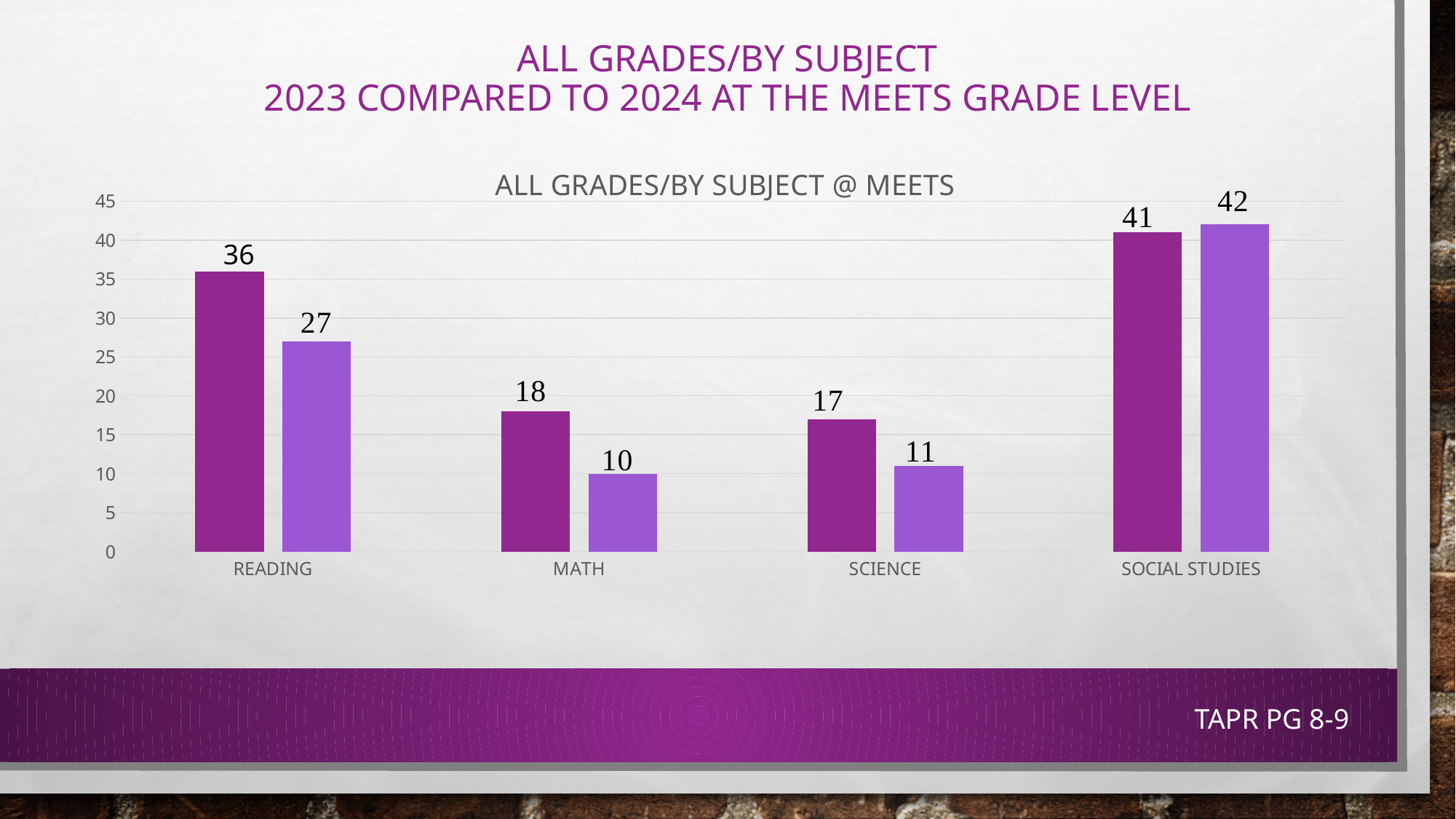
What is the value of the lighter (right) bar for Math? 10 For Math, which is larger: the darker (left) bar or the lighter (right) bar? the darker (left) bar Is the value of the darker (left) bar for Social Studies greater or less than 40? greater Which subject has the lowest value among the darker (left) bars? Science What is the value of the darker (left) bar for Science? 17 What is the difference between the darker (left) bar and the lighter (right) bar for Reading? 9 What is the title printed above the chart's plot area? ALL GRADES/BY SUBJECT @ MEETS How many subject categories are shown on the x axis of the chart? 4 Which subject has the highest value among the lighter (right) bars? Social Studies What is the value of the lighter (right) bar for Social Studies? 42 What type of chart is shown on the slide? bar chart What is the value of the darker (left) bar for Reading? 36